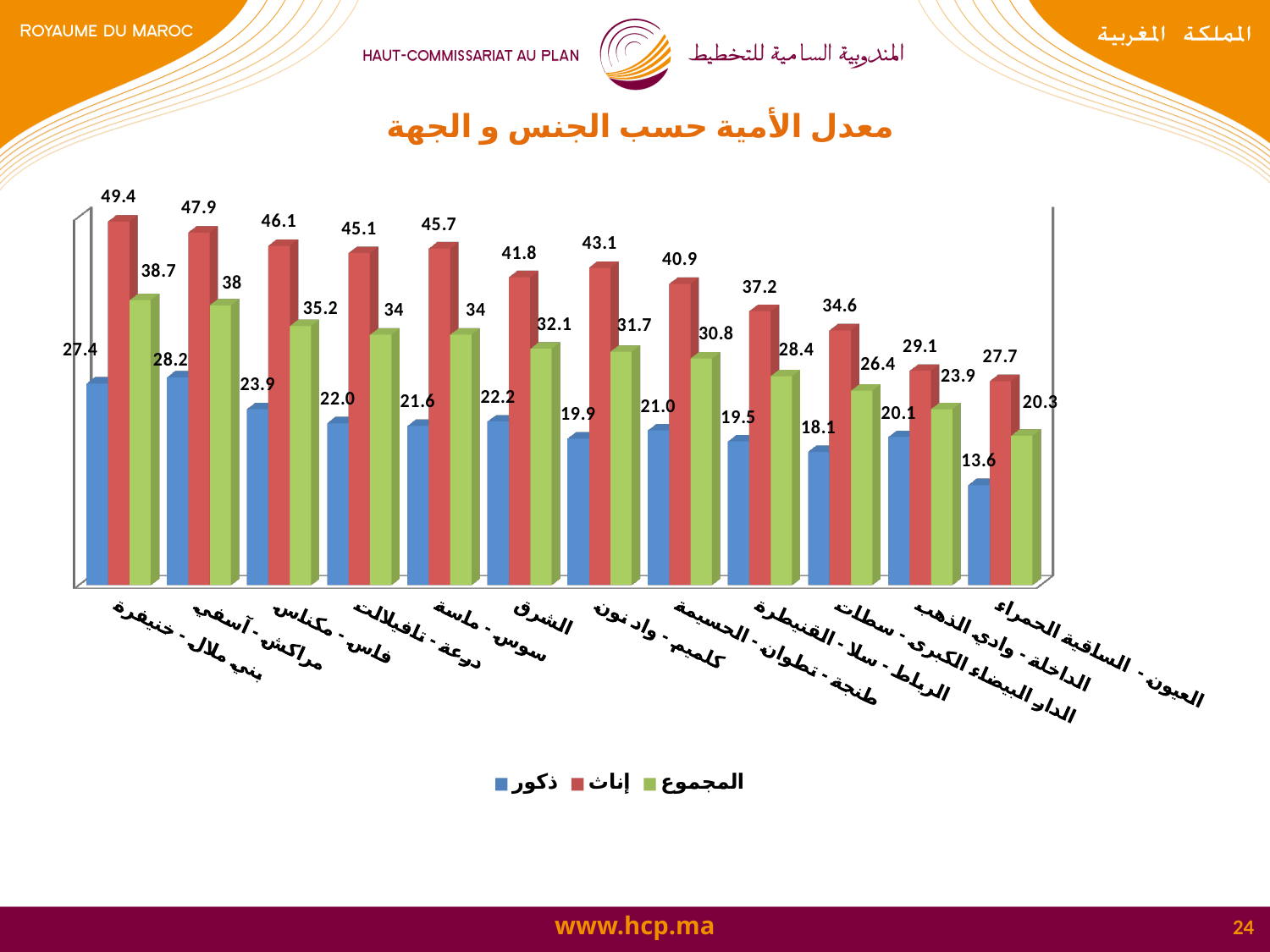
What kind of chart is shown on the slide? Bar chart How many regions are shown on the chart? 12 How many series does the legend list? 3 Which colour represents the female (إناث) series in the chart? Red What is the difference between the female and male illiteracy rates for مراكش - آسفي? 19.7 What is the male (ذكور) illiteracy rate for العيون - الساقية الحمراء? 13.6 Which is larger, the total (المجموع) rate for فاس - مكناس or for درعة - تافيلالت? فاس - مكناس Which region has the lowest male (ذكور) illiteracy rate? العيون - الساقية الحمراء What is the total (المجموع) illiteracy rate for الشرق? 32.1 Which region has the highest female (إناث) illiteracy rate? بني ملال - خنيفرة What is the female (إناث) illiteracy rate for بني ملال - خنيفرة? 49.4 Do the female (إناث) illiteracy rates generally rise or fall from left to right across the regions? Fall